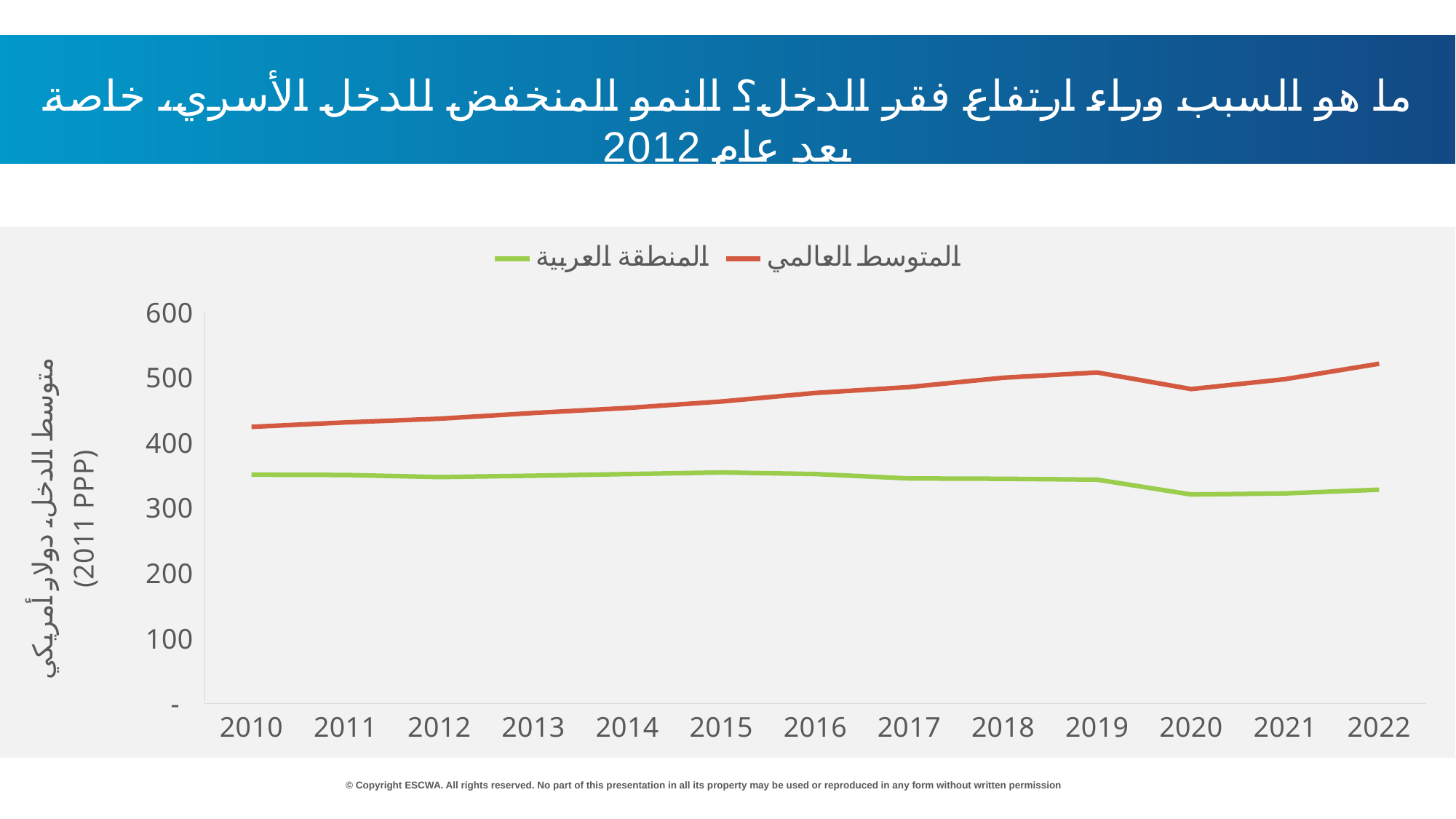
How many years are shown on the x axis? 13 Which series has the higher value in 2022, المتوسط العالمي or المنطقة العربية? المتوسط العالمي Does the value for المنطقة العربية rise or fall from 2015 to 2020? fall Is the value for المتوسط العالمي in 2022 greater or less than 500? greater What colour is the line for المنطقة العربية? green In which year is the value for المتوسط العالمي lowest? 2010 What kind of chart is shown on the slide? line chart Is the value for المنطقة العربية in 2020 greater or less than 350? less Is the value for المنطقة العربية in 2010 greater or less than 400? less Does the value for المتوسط العالمي generally rise or fall from 2010 to 2022? rise How many series does the legend list? 2